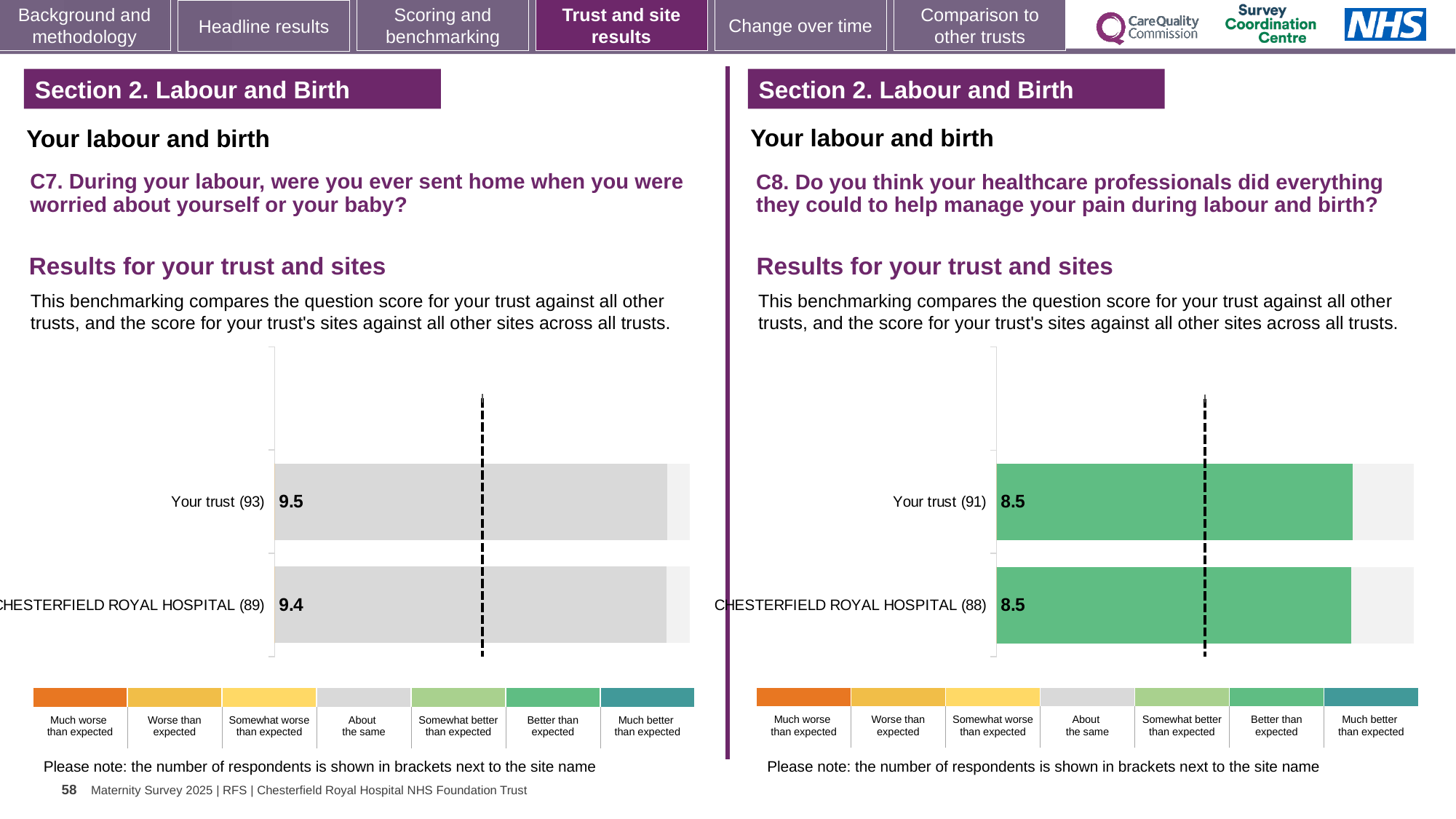
In the C8 chart on the right, what is the score for Your trust? 8.5 How many bars are plotted in the C8 chart on the right? 2 In the C7 chart on the left, which has the higher score, Your trust or Chesterfield Royal Hospital? Your trust In the C7 chart on the left, what is the score for Chesterfield Royal Hospital? 9.4 According to the colour key, which benchmarking category do the green bars in the C8 chart on the right represent? Better than expected In the C7 chart on the left, how many respondents are shown in brackets for Your trust? 93 In the C8 chart on the right, how many respondents are shown in brackets for Chesterfield Royal Hospital? 88 According to the colour key, which benchmarking category do the grey bars in the C7 chart on the left represent? About the same In the C7 chart on the left, what is the difference between the score for Your trust and the score for Chesterfield Royal Hospital? 0.1 In the C7 chart on the left, what is the score for Your trust? 9.5 What type of chart is used in the C7 chart on the left? Bar chart In the C8 chart on the right, what is the score for Chesterfield Royal Hospital? 8.5